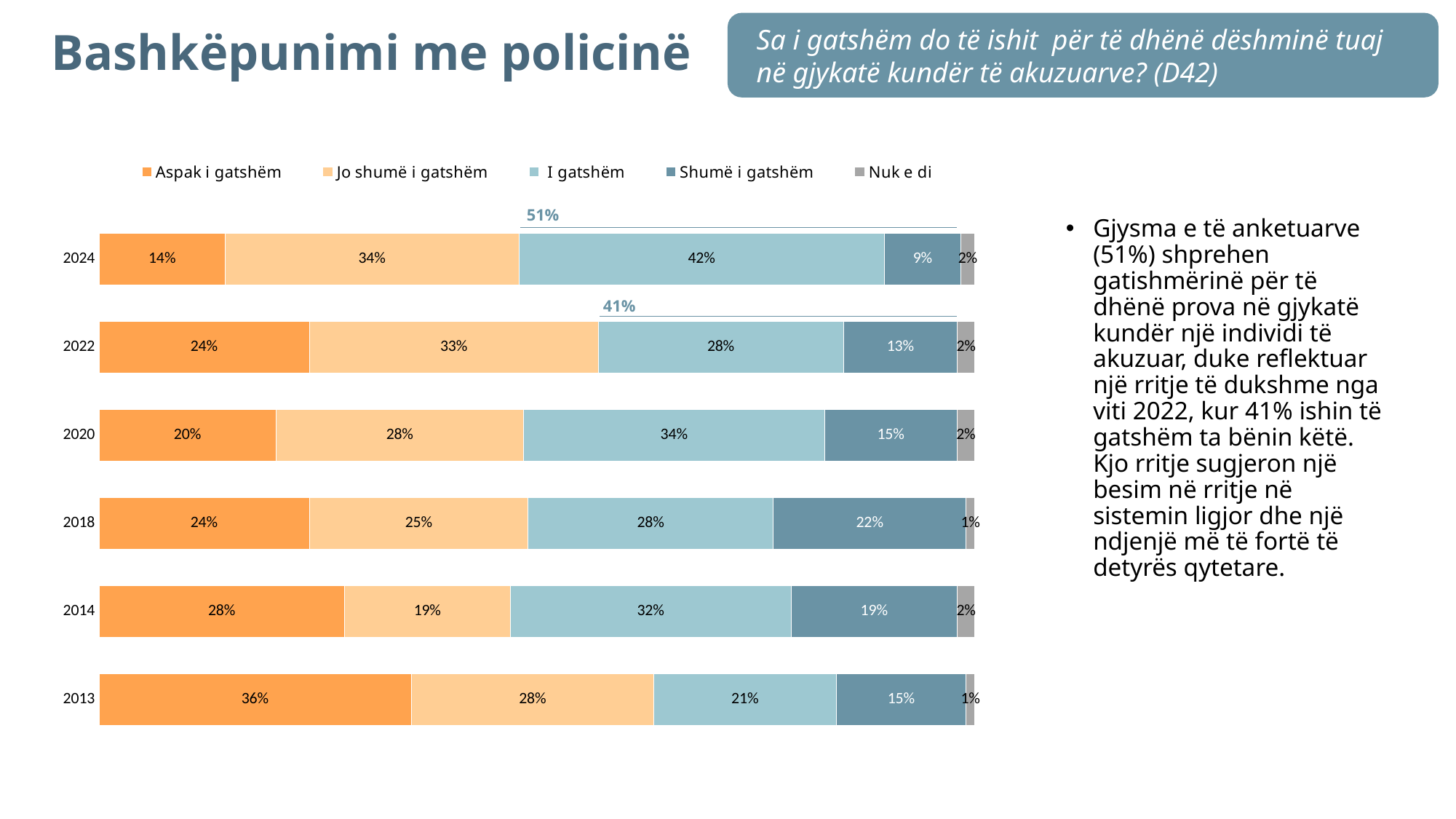
In which year is the "Aspak i gatshëm" segment the smallest? 2024 How many response categories does the legend list? 5 What percentage of respondents in 2024 answered "I gatshëm"? 42% By how many percentage points did the "I gatshëm" share in 2024 exceed that in 2022? 14 percentage points What is the value for "Aspak i gatshëm" in 2013? 36% In which year is the "Aspak i gatshëm" segment the largest? 2013 What colour represents "Aspak i gatshëm" in the legend? Orange What is the combined share of "I gatshëm" and "Shumë i gatshëm" in 2024, as labelled above the bar? 51% What type of chart is shown on the slide? Stacked bar chart How many years are shown on the chart? 6 Which year has the larger "Jo shumë i gatshëm" share, 2020 or 2014? 2020 What share of respondents in 2018 answered "Shumë i gatshëm"? 22%